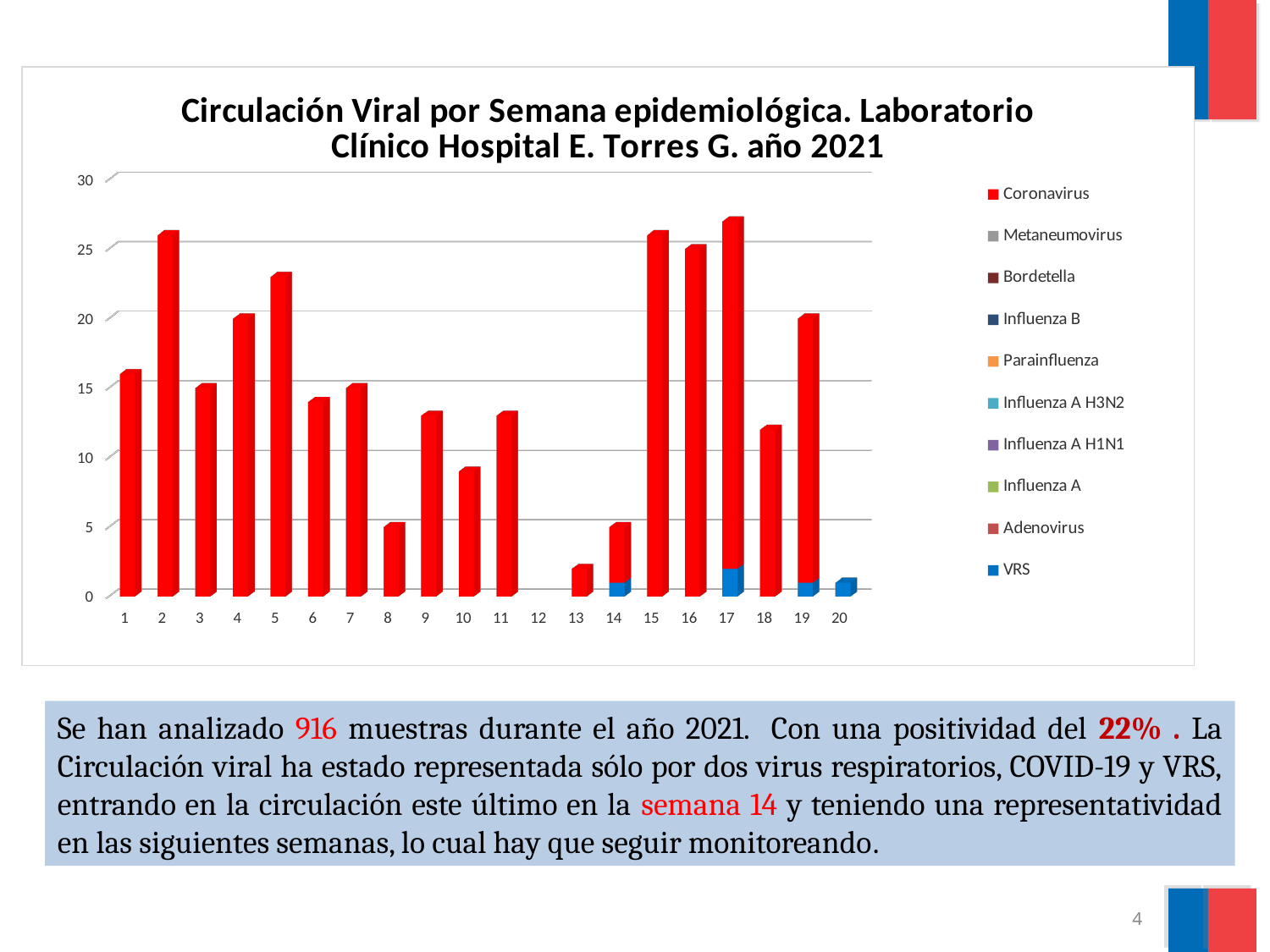
Which week has no bar at all (the lowest value) in the chart? 12 What kind of chart is shown on the slide? bar chart What colour represents Coronavirus in the chart? red How many epidemiological weeks are shown on the x axis of the chart? 20 What is the last entry listed in the chart's legend? VRS Is the value for week 8 greater or less than 10? less Is the value for week 18 greater or less than 10? greater Is the value for week 2 greater or less than 25? greater How many series does the chart's legend list? 10 Which week has the taller bar, week 15 or week 18? week 15 Which week has the taller bar, week 2 or week 3? week 2